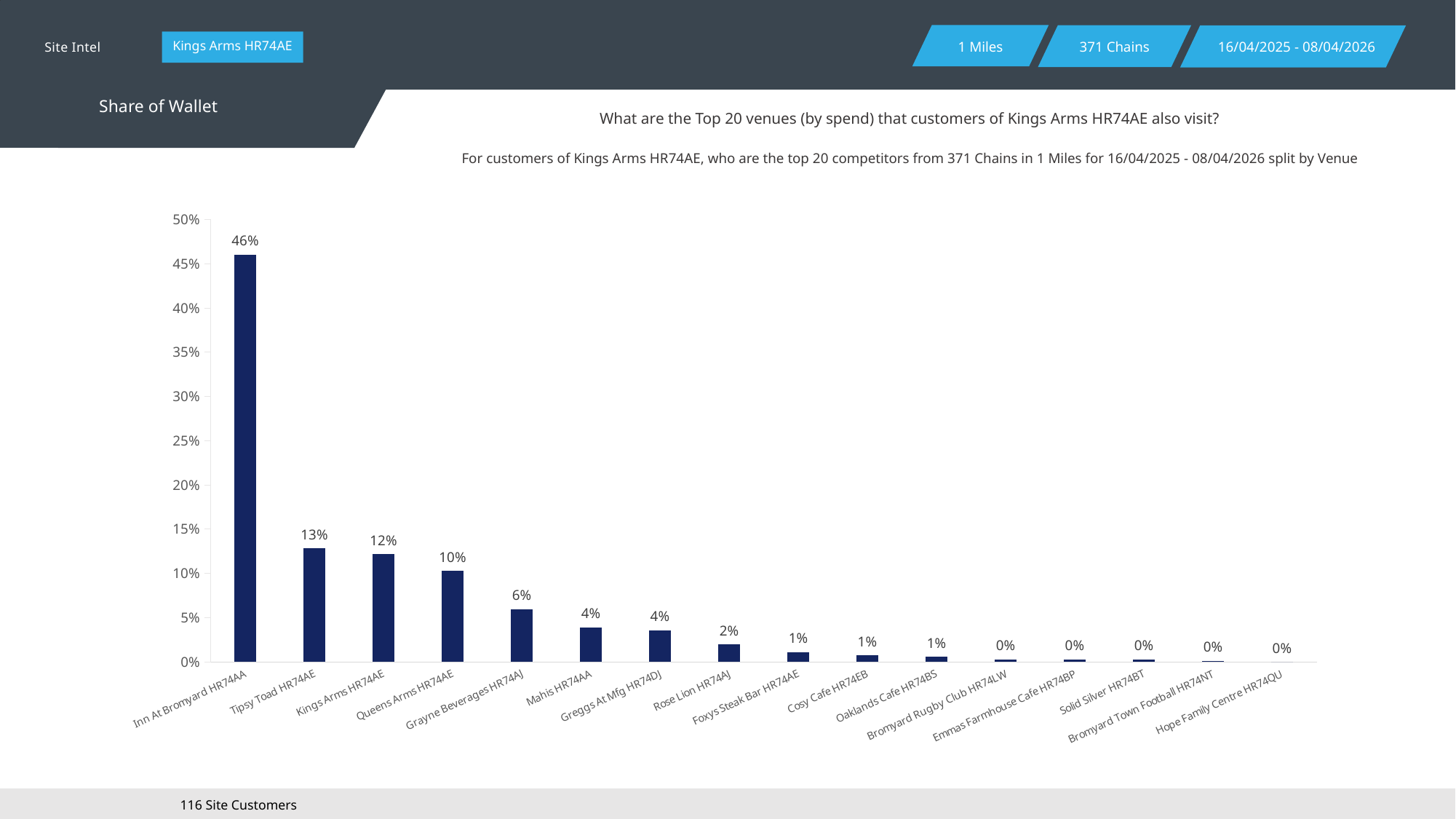
Which is larger, the value for Mahis HR74AA or the value for Rose Lion HR74AJ? Mahis HR74AA What kind of chart is shown on the slide? bar chart How many venues are shown on the x axis? 16 What is the value for Rose Lion HR74AJ? 2% What is the difference between the values for Inn At Bromyard HR74AA and Tipsy Toad HR74AE? 33% What is the value for Inn At Bromyard HR74AA? 46% Which venue has the highest value? Inn At Bromyard HR74AA What is the value for Queens Arms HR74AE? 10% Is the value for Inn At Bromyard HR74AA greater or less than 40%? greater What is the value for Tipsy Toad HR74AE? 13% What is the difference between the values for Kings Arms HR74AE and Queens Arms HR74AE? 2% What is the value for Grayne Beverages HR74AJ? 6%